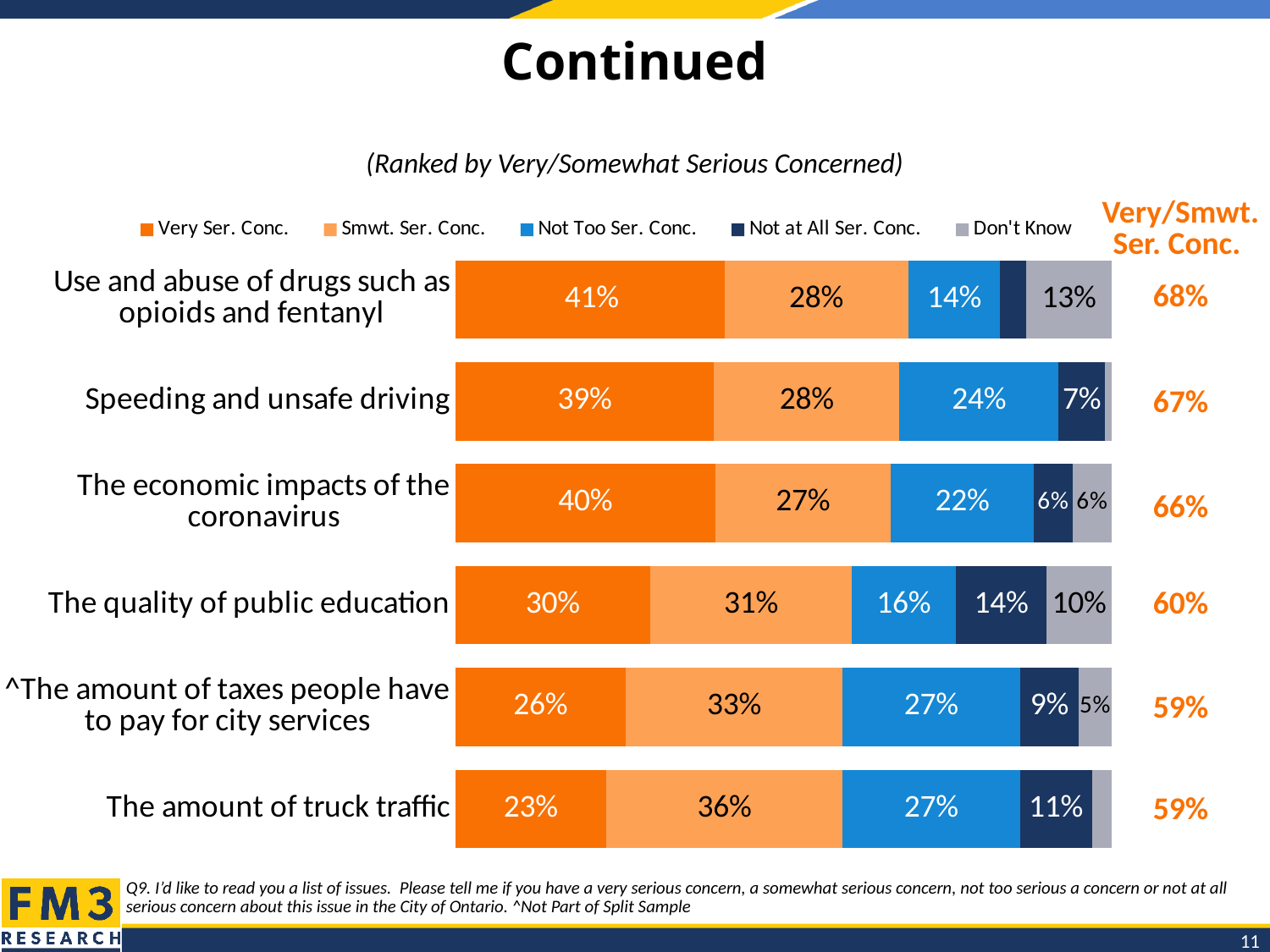
What is the Don't Know value for 'Use and abuse of drugs such as opioids and fentanyl'? 13% Which is larger: the Not at All Ser. Conc. value for 'The quality of public education' or for 'The amount of truck traffic'? The quality of public education How many issues (categories) are plotted in the chart? 6 What is the Smwt. Ser. Conc. value for 'The amount of truck traffic'? 36% What is the Very/Smwt. Ser. Conc. total shown for 'The quality of public education'? 60% Which issue has the lowest Very Ser. Conc. value? The amount of truck traffic How many series does the legend list? 5 What is the difference between the Very Ser. Conc. values for 'The economic impacts of the coronavirus' and 'The quality of public education'? 10% What is the Very Ser. Conc. value for 'Use and abuse of drugs such as opioids and fentanyl'? 41% Which issue has the highest Very Ser. Conc. value? Use and abuse of drugs such as opioids and fentanyl What kind of chart is shown on the slide? Stacked bar chart What is the Not Too Ser. Conc. value for 'Speeding and unsafe driving'? 24%